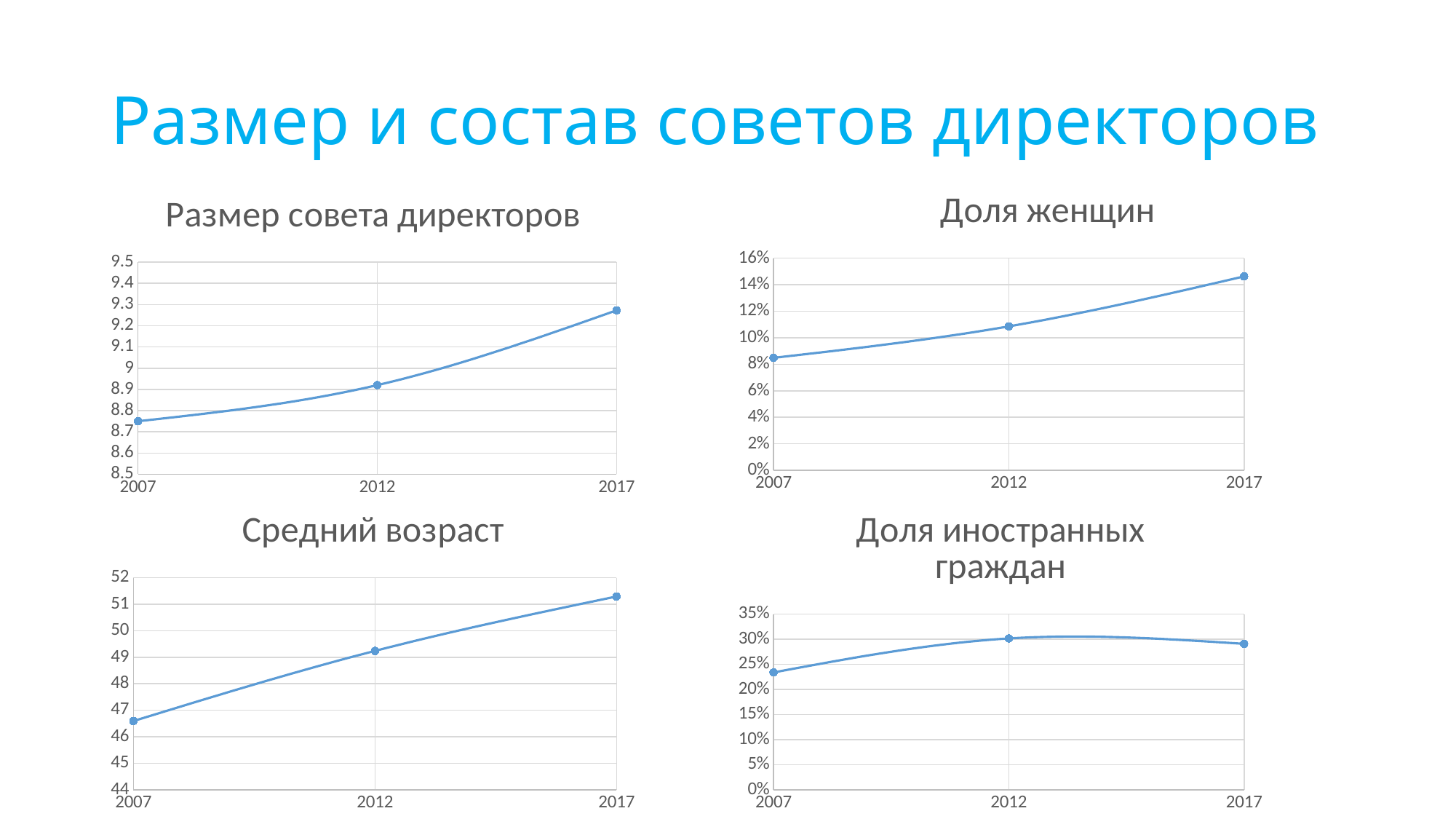
What kind of chart is the "Размер совета директоров" chart? line chart How many charts are shown on the slide? 4 On the "Доля иностранных граждан" chart, is the value for 2007 greater or less than 25%? less On the "Средний возраст" chart, which year has the lowest value? 2007 On the "Размер совета директоров" chart, is the value for 2012 greater or less than 9? less On the "Доля иностранных граждан" chart, which year has the lowest value? 2007 On the "Доля иностранных граждан" chart, which is larger, the value for 2007 or the value for 2012? 2012 On the "Средний возраст" chart, is the value for 2007 greater or less than 47? less How many data points are plotted on the "Доля женщин" chart? 3 On the "Доля женщин" chart, which year has the highest value? 2017 On the "Размер совета директоров" chart, do the values rise or fall from 2007 to 2017? rise